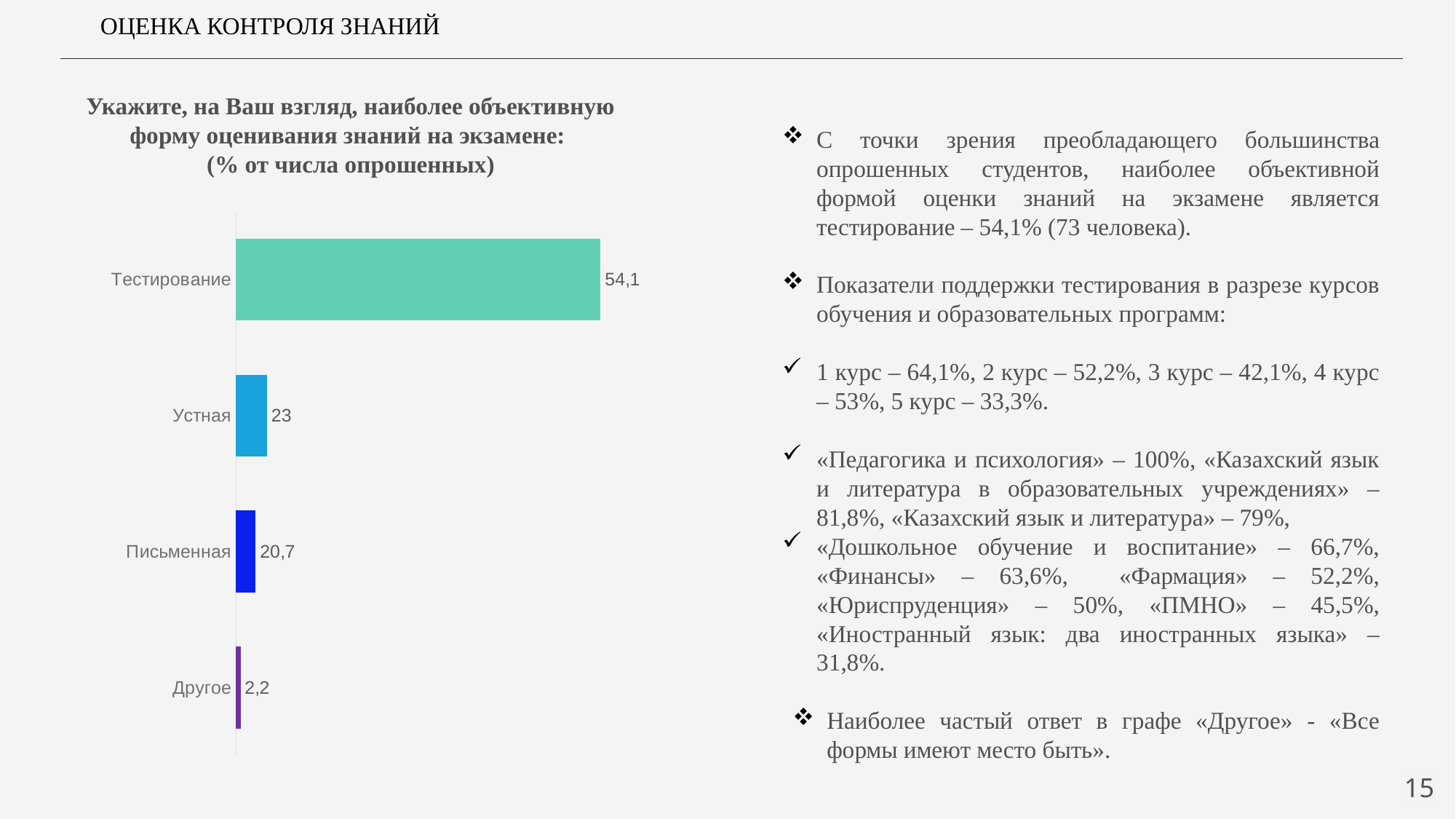
How many categories are shown in the chart? 4 What value is shown for Тестирование? 54,1 What value is shown for Устная? 23 What is the difference between the values for Тестирование and Устная? 31,1 What value is shown for Другое? 2,2 Which is larger, the value for Устная or the value for Письменная? Устная What value is shown for Письменная? 20,7 What is the difference between the values for Устная and Письменная? 2,3 Which category has the highest value? Тестирование What kind of chart is shown on the slide? bar chart What colour is the bar for Тестирование? teal (green) Which category has the lowest value? Другое